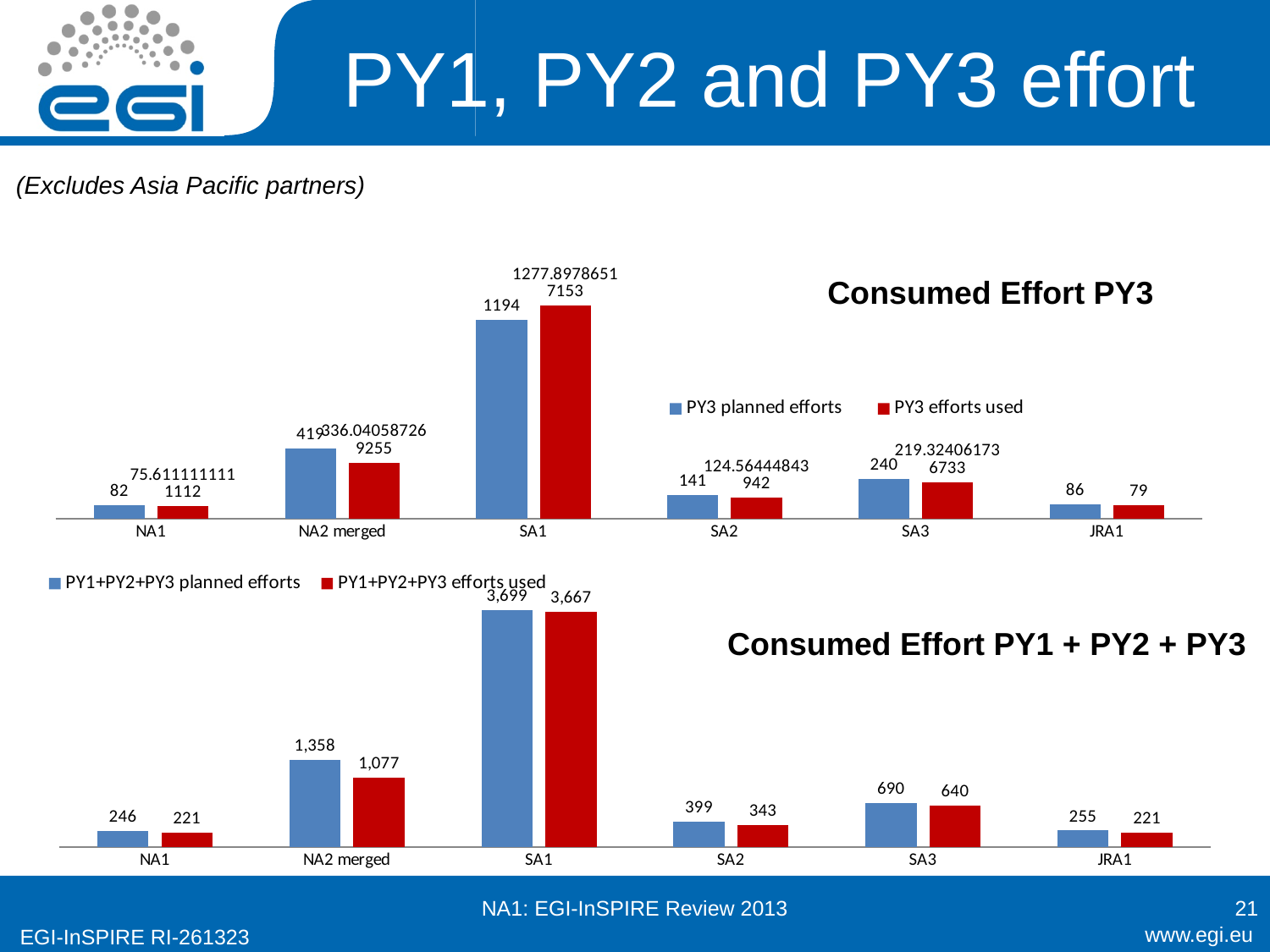
In the 'Consumed Effort PY1 + PY2 + PY3' chart, how many categories are shown on the x axis? 6 In the 'Consumed Effort PY3' chart, how many series does the legend list? 2 In the 'Consumed Effort PY3' chart, which category has the highest PY3 planned effort? SA1 In the 'Consumed Effort PY1 + PY2 + PY3' chart, what is the difference between the planned effort and the effort used for SA1? 32 In the 'Consumed Effort PY1 + PY2 + PY3' chart, which is larger for SA2: the planned effort or the effort used? planned effort In the 'Consumed Effort PY1 + PY2 + PY3' chart, what is the PY1+PY2+PY3 effort used for NA2 merged? 1,077 In the 'Consumed Effort PY3' chart, what is the PY3 effort used for JRA1? 79 In the 'Consumed Effort PY3' chart, which category has the lowest PY3 planned effort? NA1 In the 'Consumed Effort PY3' chart, what is the PY3 planned effort for SA1? 1194 In the 'Consumed Effort PY1 + PY2 + PY3' chart, what is the PY1+PY2+PY3 planned effort for SA3? 690 In the 'Consumed Effort PY3' chart, what is the PY3 planned effort for NA2 merged? 419 What type of chart is the 'Consumed Effort PY1 + PY2 + PY3' chart? bar chart